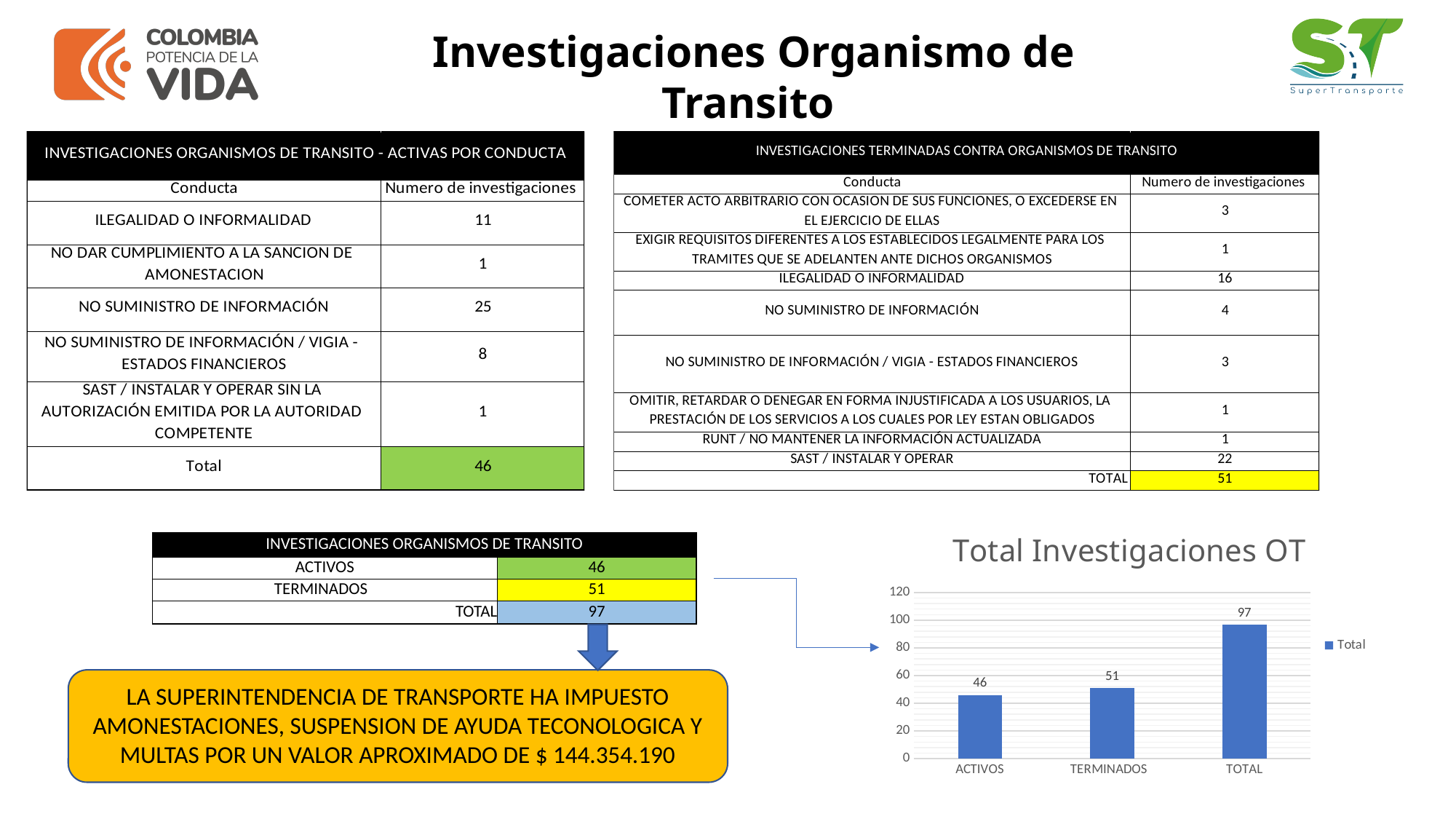
In the Total Investigaciones OT chart, which is larger, ACTIVOS or TERMINADOS? TERMINADOS How many series does the legend of the Total Investigaciones OT chart list? 1 What is the value for ACTIVOS in the Total Investigaciones OT chart? 46 Is the value for TOTAL in the Total Investigaciones OT chart greater or less than 80? greater What is the difference between the TERMINADOS and ACTIVOS values in the Total Investigaciones OT chart? 5 Which category has the highest value in the Total Investigaciones OT chart? TOTAL How many categories are shown on the x axis of the Total Investigaciones OT chart? 3 What is the title of the chart on the slide? Total Investigaciones OT What kind of chart is the Total Investigaciones OT chart? bar chart What is the value for TERMINADOS in the Total Investigaciones OT chart? 51 What is the value for TOTAL in the Total Investigaciones OT chart? 97 Which category has the lowest value in the Total Investigaciones OT chart? ACTIVOS